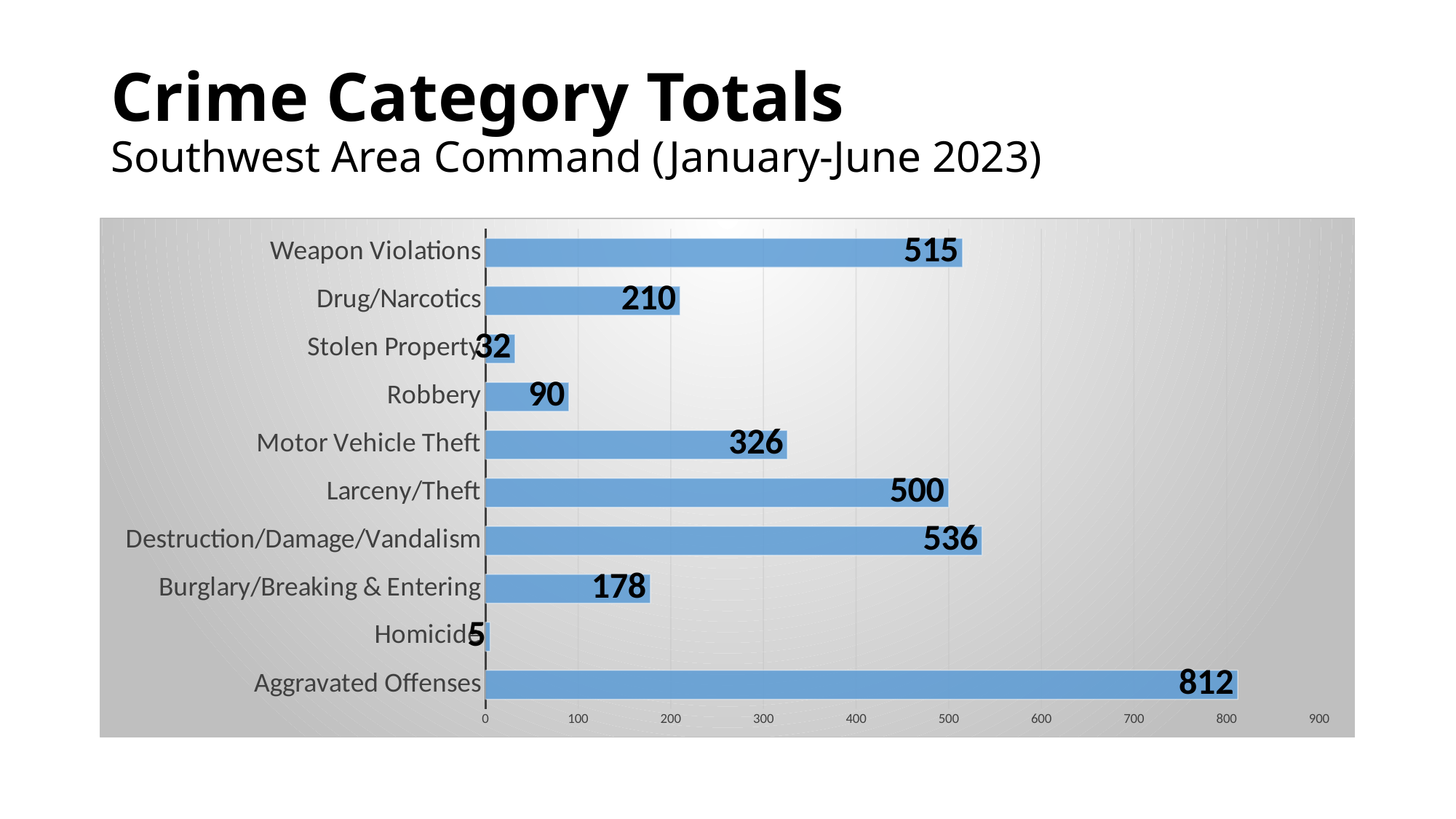
Which category has the lowest value? Homicide Is the value for Larceny/Theft greater or less than 400? greater What is the value for Burglary/Breaking & Entering? 178 What is the subtitle of the slide below the chart title? Southwest Area Command (January-June 2023) What is the difference between Destruction/Damage/Vandalism and Larceny/Theft? 36 What is the value for Weapon Violations? 515 Which is larger, Drug/Narcotics or Robbery? Drug/Narcotics What is the difference between Aggravated Offenses and Weapon Violations? 297 What is the value for Motor Vehicle Theft? 326 Which category has the highest value? Aggravated Offenses What kind of chart is shown on the slide? bar chart How many categories are shown in the chart? 10